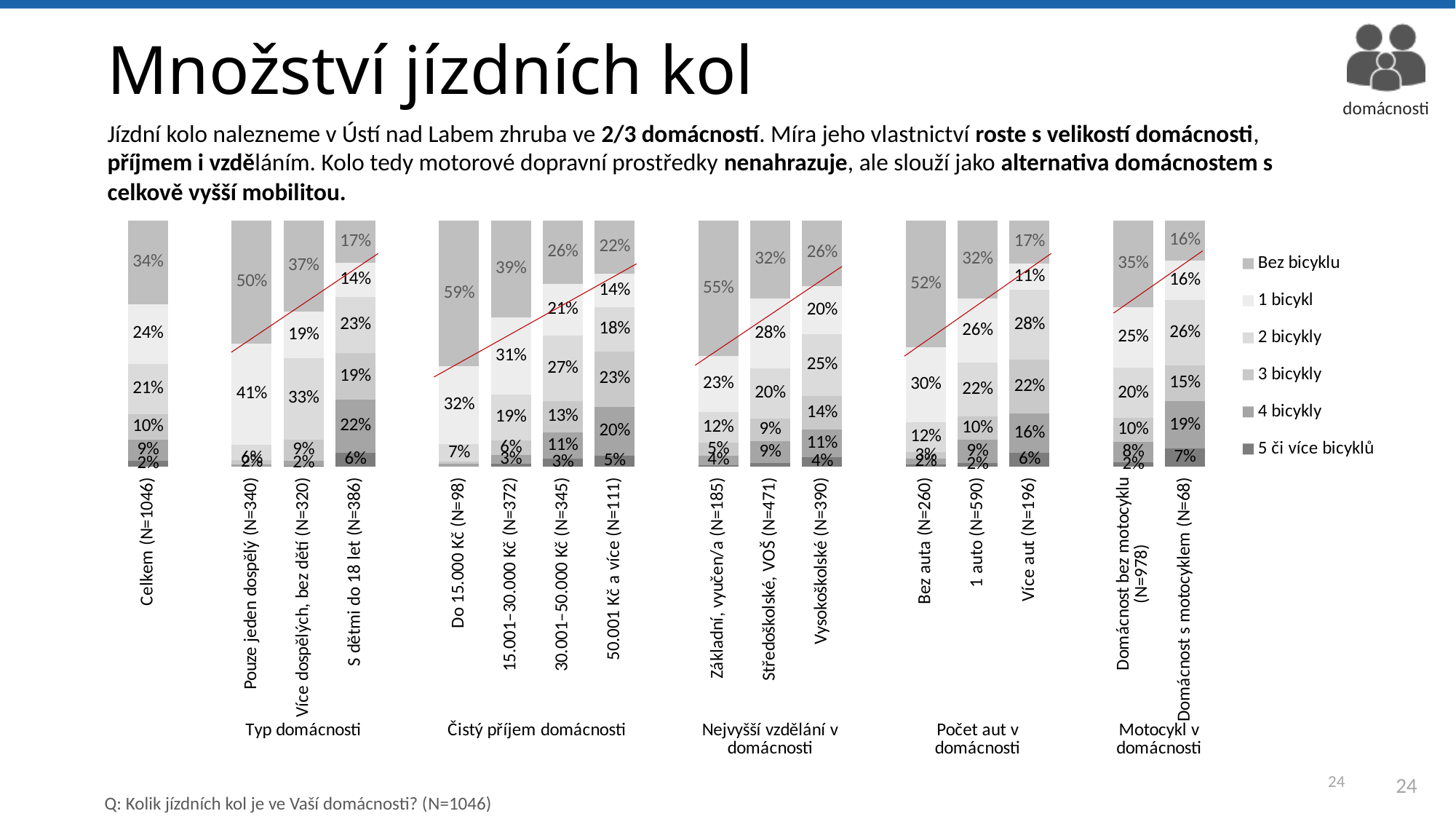
What is the '4 bicykly' share for households S dětmi do 18 let (N=386)? 22% How many series does the legend list? 6 Which has a larger 'Bez bicyklu' share: Základní, vyučen/a (N=185) or Vysokoškolské (N=390)? Základní, vyučen/a (N=185) What is the first entry in the chart legend? Bez bicyklu Which has a larger '1 bicykl' share: Pouze jeden dospělý (N=340) or Více dospělých, bez dětí (N=320)? Pouze jeden dospělý (N=340) Which category has the highest 'Bez bicyklu' share? Do 15.000 Kč (N=98) What share of all households (Celkem, N=1046) have no bicycle (Bez bicyklu)? 34% What is the 'Bez bicyklu' share for households with income Do 15.000 Kč (N=98)? 59% What is the difference between the 'Bez bicyklu' share for Bez auta (N=260) and for Více aut (N=196)? 35 percentage points What is the '2 bicykly' share for households with Více aut (N=196)? 28% Which category has the lowest 'Bez bicyklu' share? Domácnost s motocyklem (N=68) What kind of chart is shown on the slide? Stacked bar chart